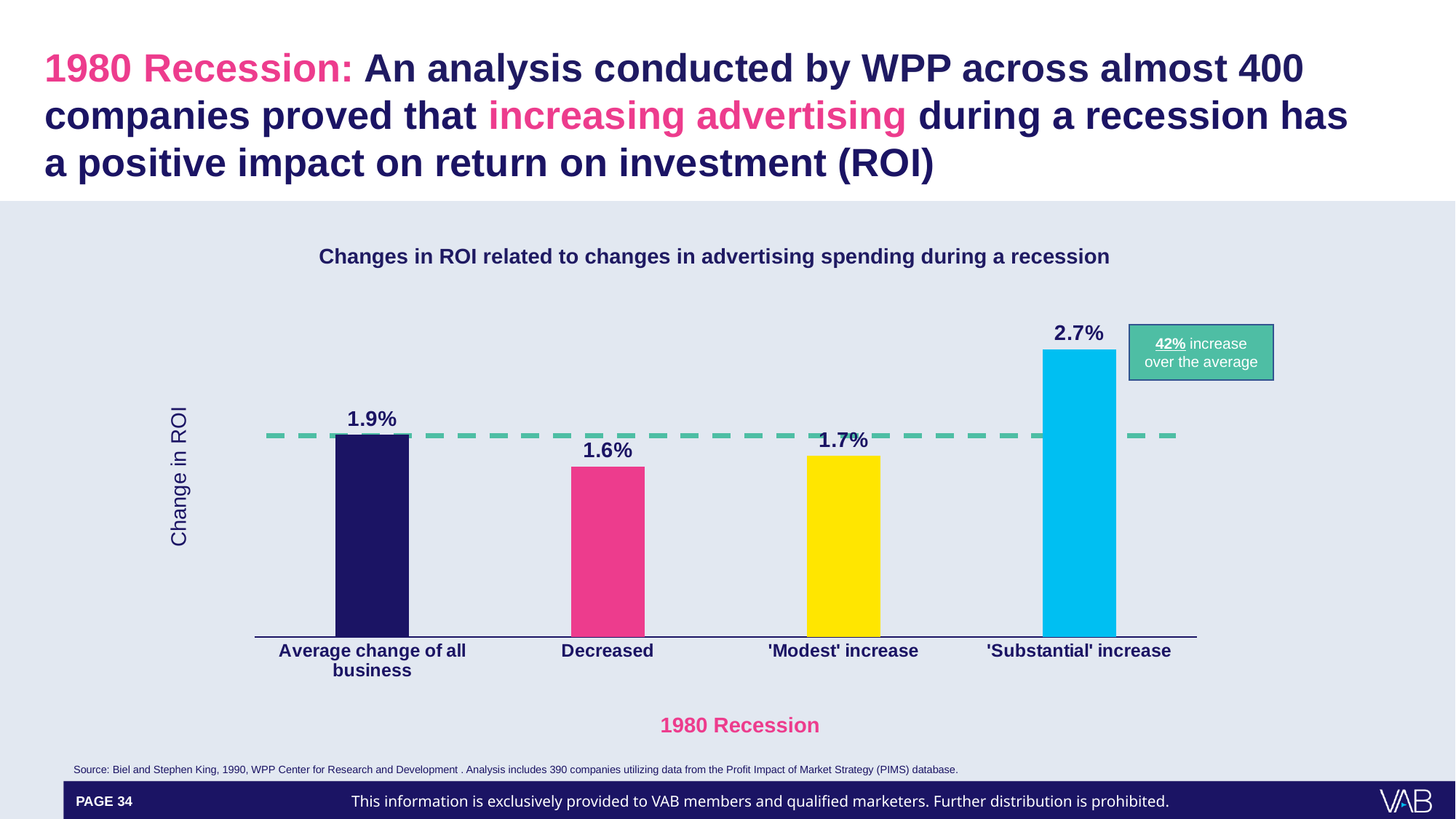
Which is larger, the value for 'Substantial' increase or the value for 'Modest' increase? 'Substantial' increase What is the change in ROI for 'Substantial' increase? 2.7% What is the title of the chart? Changes in ROI related to changes in advertising spending during a recession What kind of chart is shown on the slide? Bar chart What is the change in ROI for 'Modest' increase? 1.7% Which category has the highest change in ROI? 'Substantial' increase What is the difference between the 'Modest' increase value and the Decreased value? 0.1% What is the value for Average change of all business? 1.9% Which category has the lowest change in ROI? Decreased What is the difference between the 'Substantial' increase value and the Average change of all business value? 0.8% What is the change in ROI for Decreased? 1.6% How many categories are shown on the x axis? 4